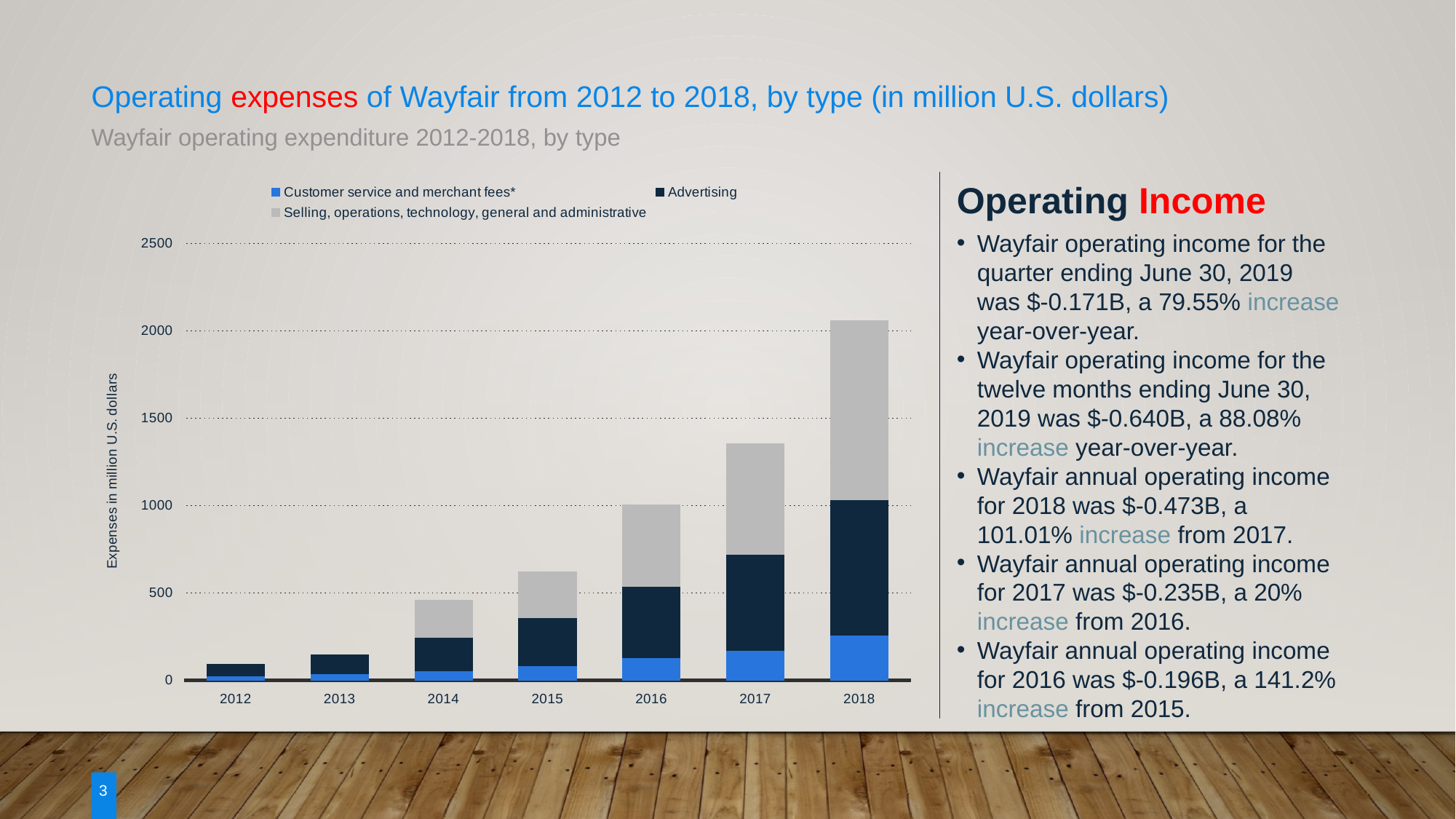
Do total operating expenses rise or fall from 2012 to 2018? Rise What is the label on the y axis of the chart? Expenses in million U.S. dollars Which year has the shortest stacked bar (lowest total operating expenses)? 2012 Is the total operating expenses value for 2015 greater or less than 500? greater Is the total operating expenses value for 2017 greater or less than 1000? greater Which year has larger total operating expenses, 2016 or 2018? 2018 How many series does the chart's legend list? 3 Is the total operating expenses value for 2013 greater or less than 500? less What kind of chart is shown on the slide? Stacked bar chart Which series in the legend is shown in the lightest grey colour? Selling, operations, technology, general and administrative Which year has the tallest stacked bar (highest total operating expenses)? 2018 How many years are shown on the x axis of the chart? 7